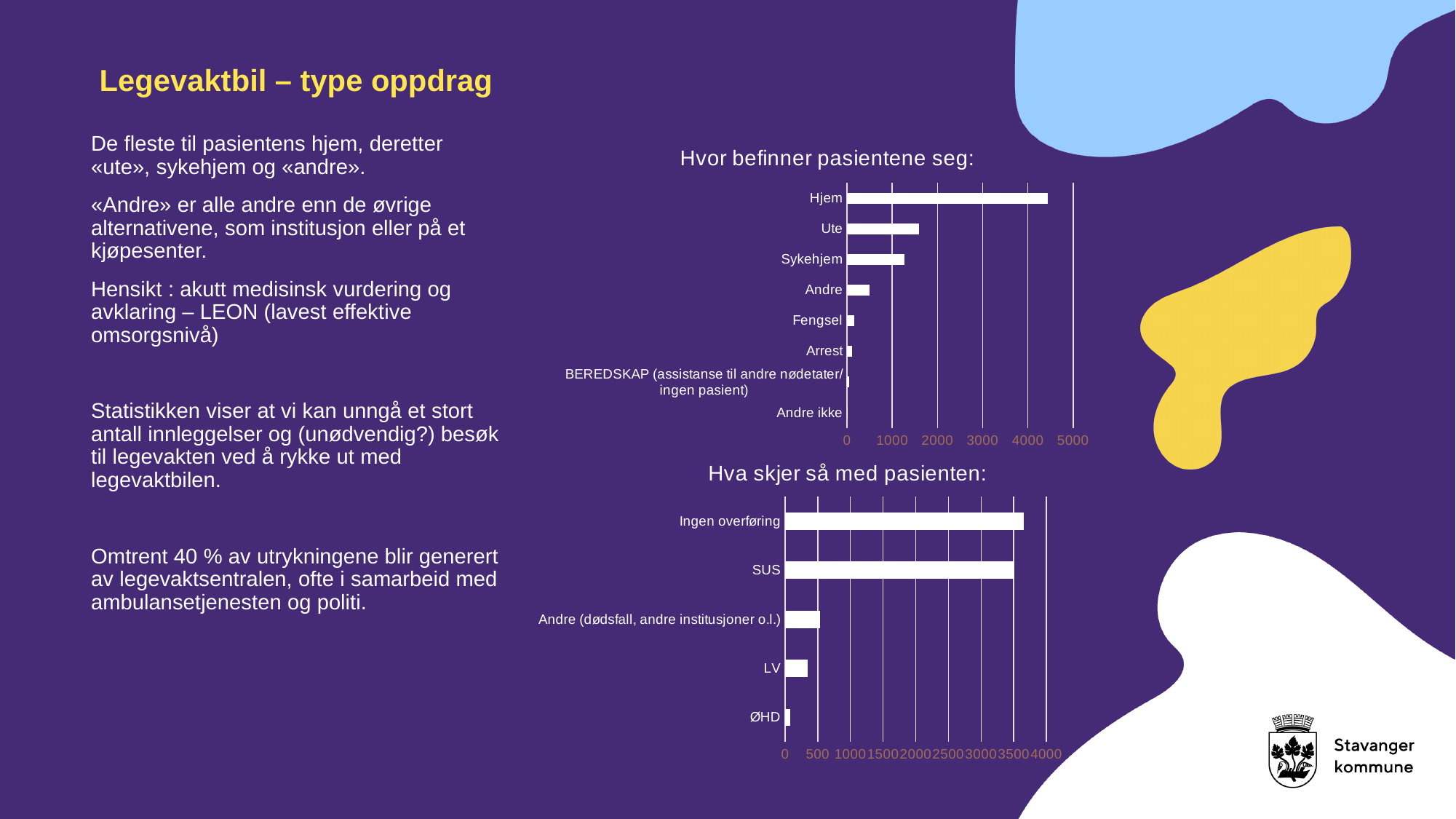
How many categories are shown in the chart titled "Hva skjer så med pasienten:"? 5 In the chart titled "Hvor befinner pasientene seg:", is the value for Andre greater or less than 1000? less In the chart titled "Hvor befinner pasientene seg:", which is larger, Ute or Sykehjem? Ute In the chart titled "Hvor befinner pasientene seg:", is the value for Ute greater or less than 1000? greater In the chart titled "Hva skjer så med pasienten:", which is larger, SUS or LV? SUS How many categories are shown in the chart titled "Hvor befinner pasientene seg:"? 8 In the chart titled "Hva skjer så med pasienten:", which category has the lowest value? ØHD In the chart titled "Hvor befinner pasientene seg:", which category has the highest value? Hjem In the chart titled "Hva skjer så med pasienten:", is the value for LV greater or less than 500? less What kind of chart is "Hvor befinner pasientene seg:"? Bar chart